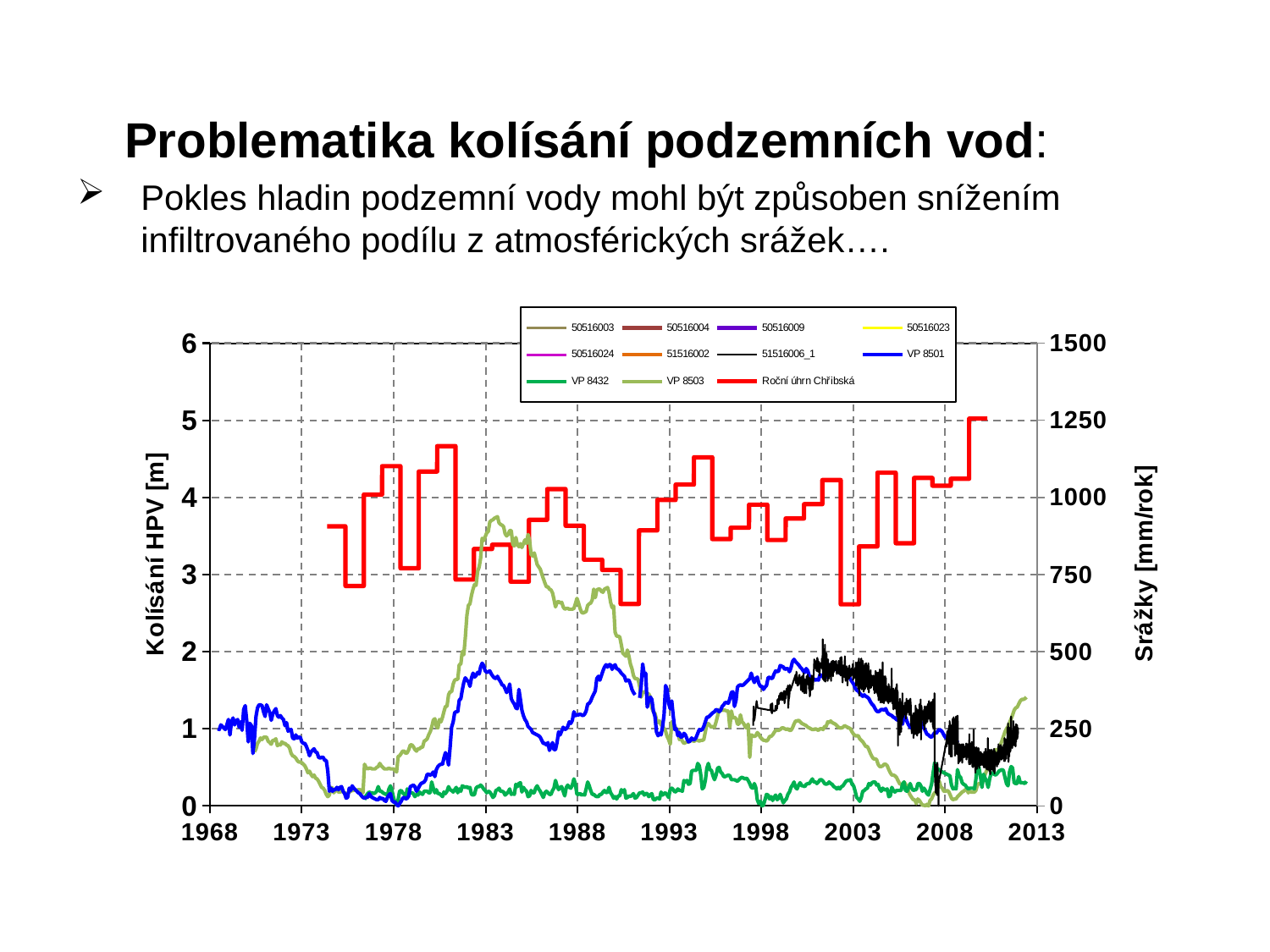
Does the VP 8501 (blue) series rise or fall between 2000 and 2008? fall How many series does the legend list? 11 What kind of chart is shown on the slide? line chart Is the value of the Roční úhrn Chřibská series around 1981 greater or less than 1000 mm/rok? greater Does the 51516006_1 (black) series rise or fall between 2001 and 2009? fall Does the VP 8432 (green) series ever exceed 1 m on the left axis? No Which is larger: the VP 8501 (blue) value around 1983 or the VP 8432 (green) value around 1983? VP 8501 Is the peak value of the VP 8501 (blue) series around 1983 greater or less than 2 m? less What is the label of the left vertical axis? Kolísání HPV [m] Which legend entry is drawn as a red line? Roční úhrn Chřibská What is the label of the right vertical axis? Srážky [mm/rok]